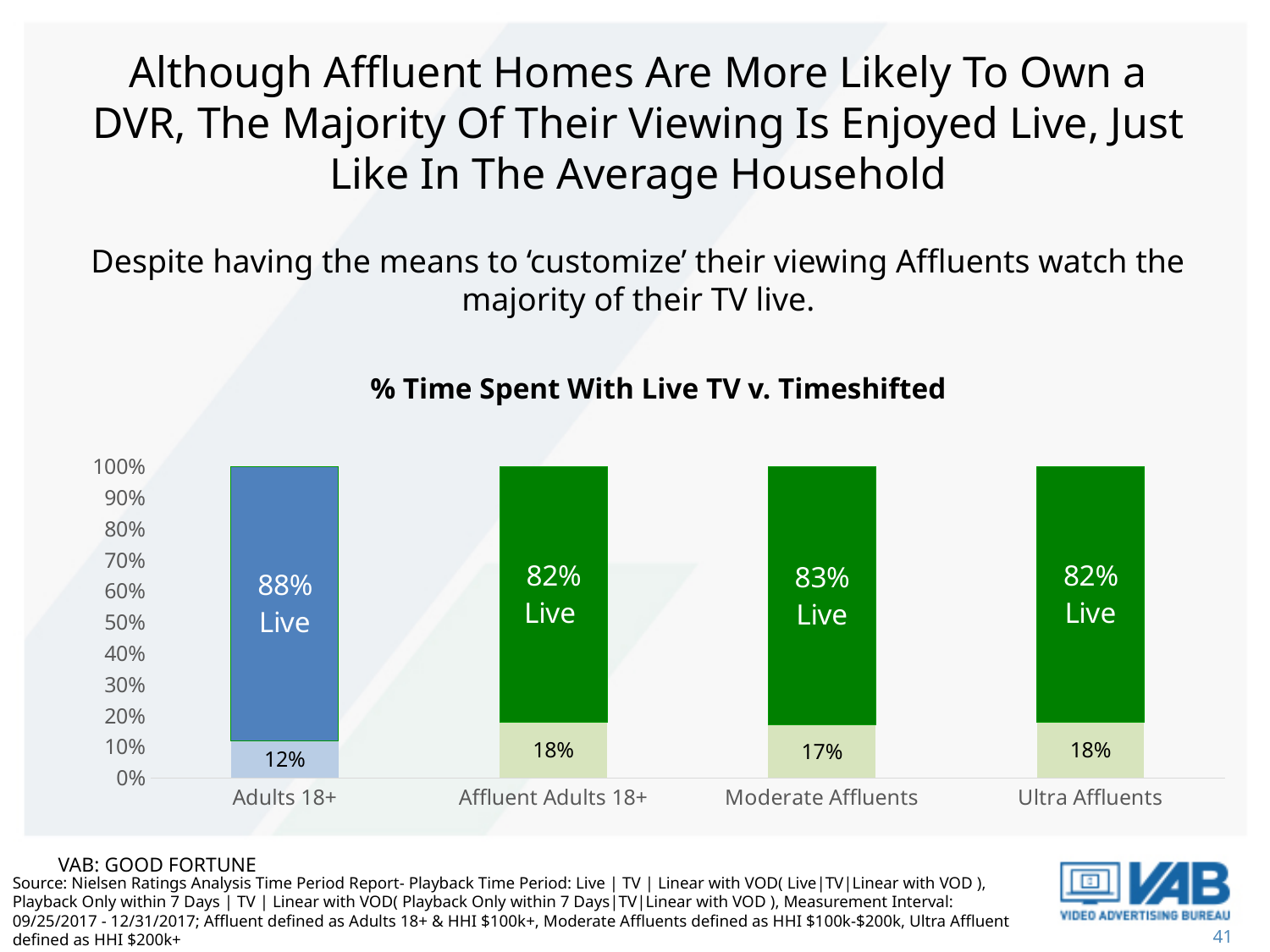
What do the live and timeshifted segments of the Moderate Affluents bar add up to? 100% What percentage of time is spent with live TV for Adults 18+? 88% What percentage of time is spent with live TV for Moderate Affluents? 83% Which category has the highest share of live TV viewing? Adults 18+ What is the chart's title? % Time Spent With Live TV v. Timeshifted Which has a larger live TV share, Adults 18+ or Moderate Affluents? Adults 18+ What is the difference in live TV share between Adults 18+ and Affluent Adults 18+? 6 percentage points Which category has the lowest timeshifted share? Adults 18+ What is the timeshifted share for Ultra Affluents? 18% How many categories are shown on the x axis of the chart? 4 What kind of chart is shown on the slide? Stacked bar chart What is the timeshifted share for Adults 18+? 12%